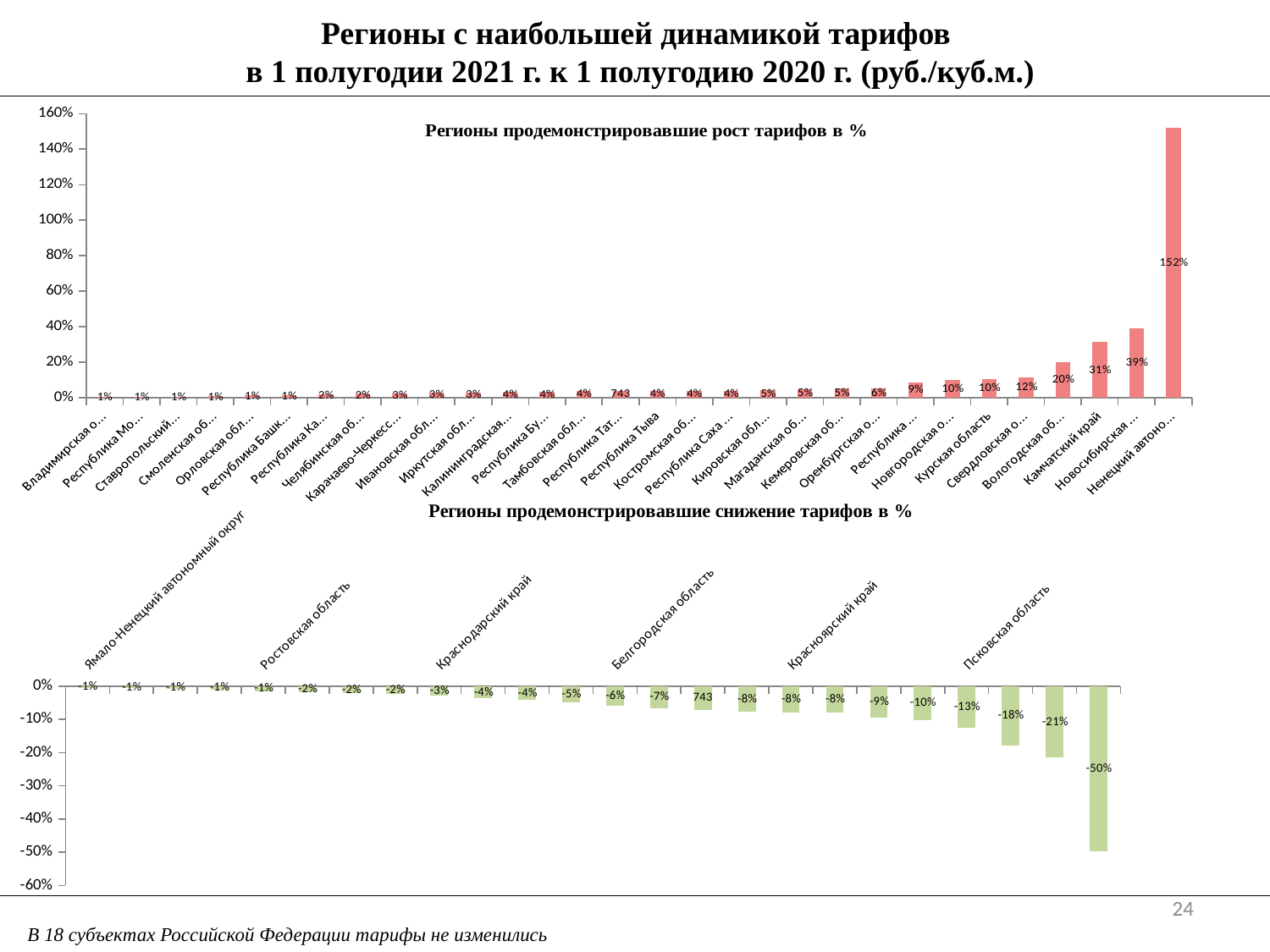
In the bottom chart 'Регионы продемонстрировавшие снижение тарифов в %', what is the lowest value shown? -50% How many bars are plotted in the top chart 'Регионы продемонстрировавшие рост тарифов в %'? 30 In the top chart 'Регионы продемонстрировавшие рост тарифов в %', what is the value for Курская область? 10% What kind of chart is the top chart, 'Регионы продемонстрировавшие рост тарифов в %'? bar chart In the top chart 'Регионы продемонстрировавшие рост тарифов в %', which is larger: the value for Камчатский край or for Республика Тыва? Камчатский край In the top chart 'Регионы продемонстрировавшие рост тарифов в %', do the values rise or fall from left to right? rise In the top chart 'Регионы продемонстрировавшие рост тарифов в %', what is the value for Республика Тыва? 4% How many bars are plotted in the bottom chart 'Регионы продемонстрировавшие снижение тарифов в %'? 24 In the top chart 'Регионы продемонстрировавшие рост тарифов в %', what is the difference between the values for Камчатский край and Курская область? 21 percentage points In the top chart 'Регионы продемонстрировавшие рост тарифов в %', what is the value for Камчатский край? 31% In the top chart 'Регионы продемонстрировавшие рост тарифов в %', what is the highest value shown? 152% In the top chart 'Регионы продемонстрировавшие рост тарифов в %', is the value for Камчатский край greater or less than 20%? greater